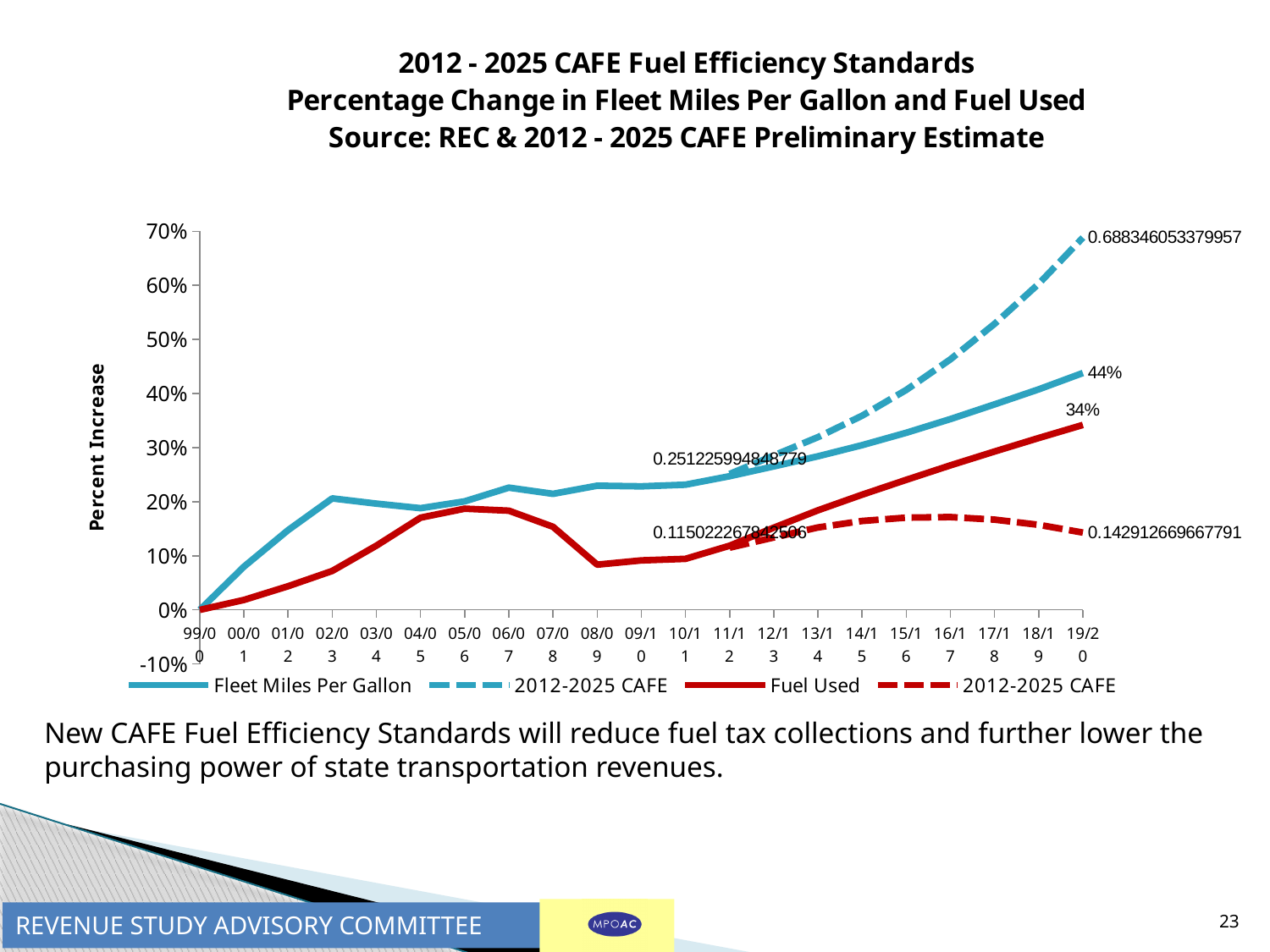
What value is labelled at the end of the dashed red 2012-2025 CAFE line at 19/20? 0.142912669667791 What kind of chart is shown on the slide? line chart What is the difference between Fleet Miles Per Gallon and Fuel Used at 19/20? 10 percentage points What value is labelled at the end of the dashed blue 2012-2025 CAFE line at 19/20? 0.688346053379957 At 19/20, which is larger: Fleet Miles Per Gallon or Fuel Used? Fleet Miles Per Gallon How many fiscal-year categories are shown on the x axis? 21 What is the value of Fuel Used at 19/20? 34% What is the value of Fleet Miles Per Gallon at 19/20? 44% How many series does the legend list? 4 Does the dashed blue 2012-2025 CAFE line rise or fall from 11/12 to 19/20? rise Is the value for Fuel Used at 08/09 greater or less than 10%? less